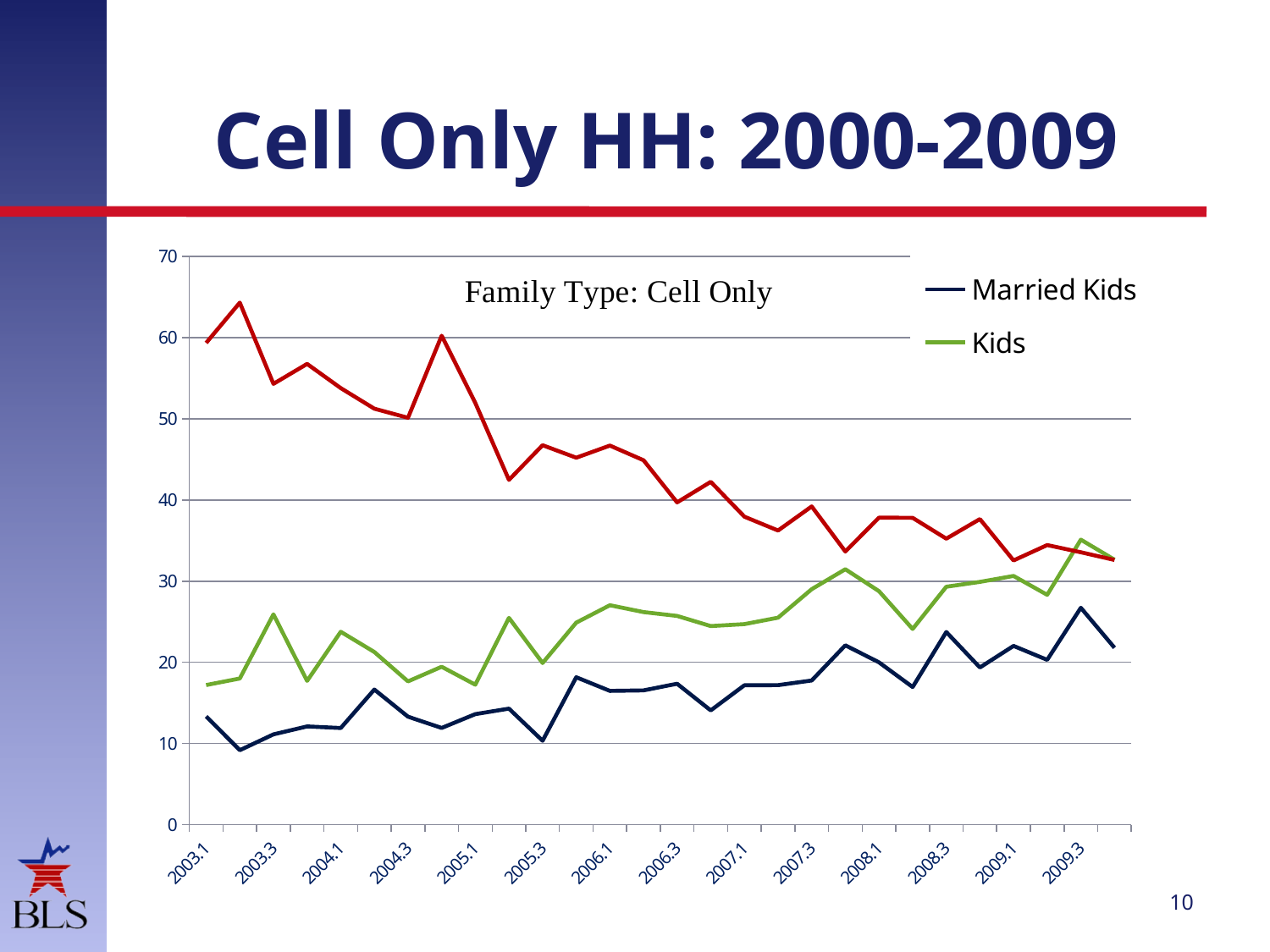
How many series does the chart's legend list? 2 At 2003.1, which series has the larger value, Kids or Married Kids? Kids What is the title printed inside the chart area? Family Type: Cell Only Is the value for Kids at 2009.3 greater or less than 30? greater Does the Kids line generally rise or fall from 2003.1 to 2009.3? rise Is the value for Kids at 2003.1 greater or less than 20? less Is the value for Married Kids at 2009.3 greater or less than 20? greater Does the Married Kids line generally rise or fall from 2003.1 to 2009.3? rise How many labels are shown on the x axis? 14 What colour is the line for the Kids series? green What kind of chart is shown on the slide? line chart